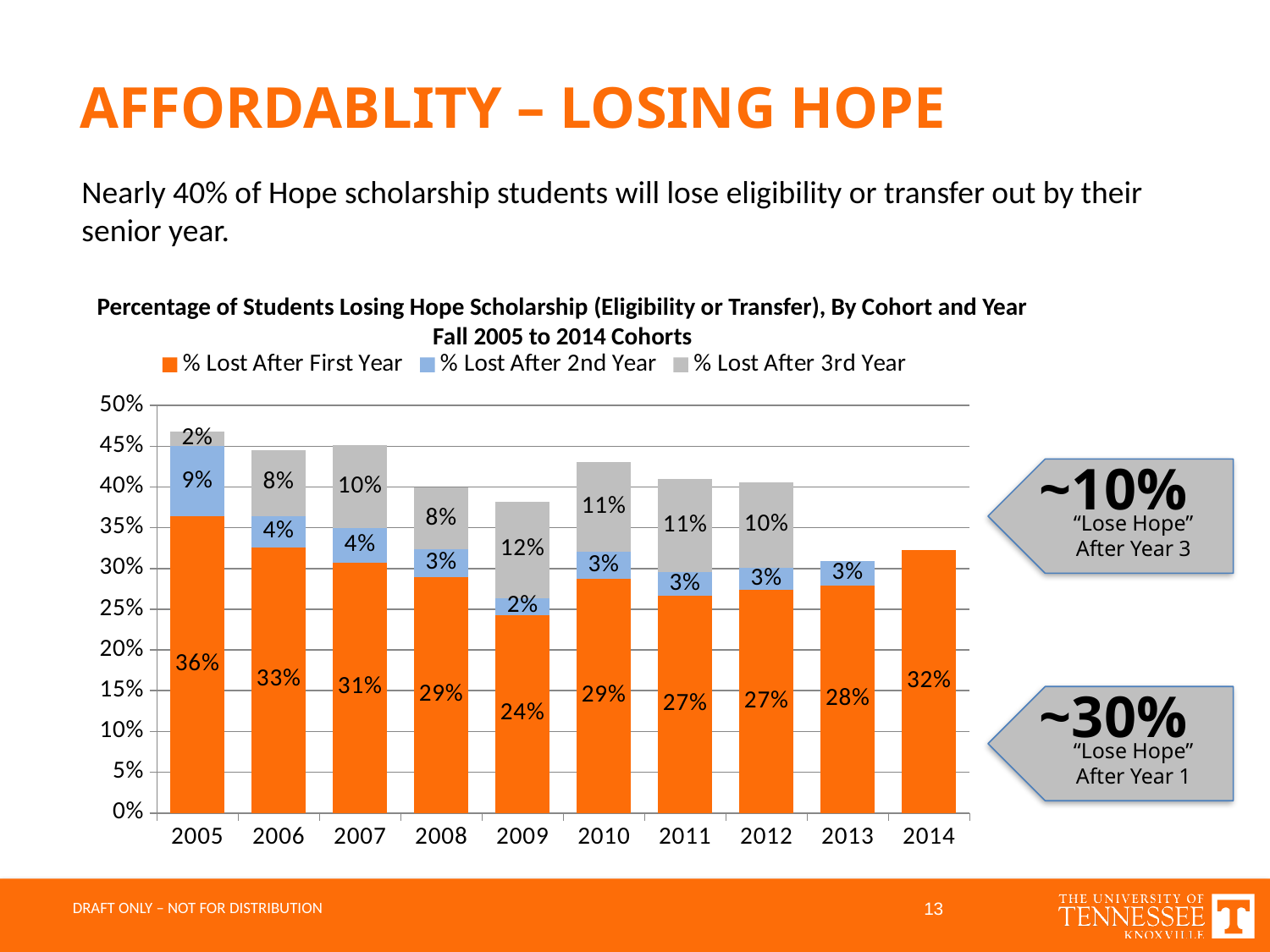
What kind of chart is shown on the slide? Stacked bar chart Which cohort has the lowest % Lost After First Year? 2009 Which cohort has the highest % Lost After 3rd Year? 2009 How many cohorts are shown on the x axis? 10 Which cohort has a larger % Lost After 2nd Year, 2005 or 2006? 2005 What is the % Lost After 3rd Year for the 2009 cohort? 12% What is the % Lost After First Year for the 2009 cohort? 24% How many series does the legend list? 3 Which cohort has the highest % Lost After First Year? 2005 Is the value for the 2014 cohort greater or less than 30%? greater What is the difference in % Lost After First Year between the 2005 and 2009 cohorts? 12 percentage points What is the % Lost After 2nd Year for the 2005 cohort? 9%